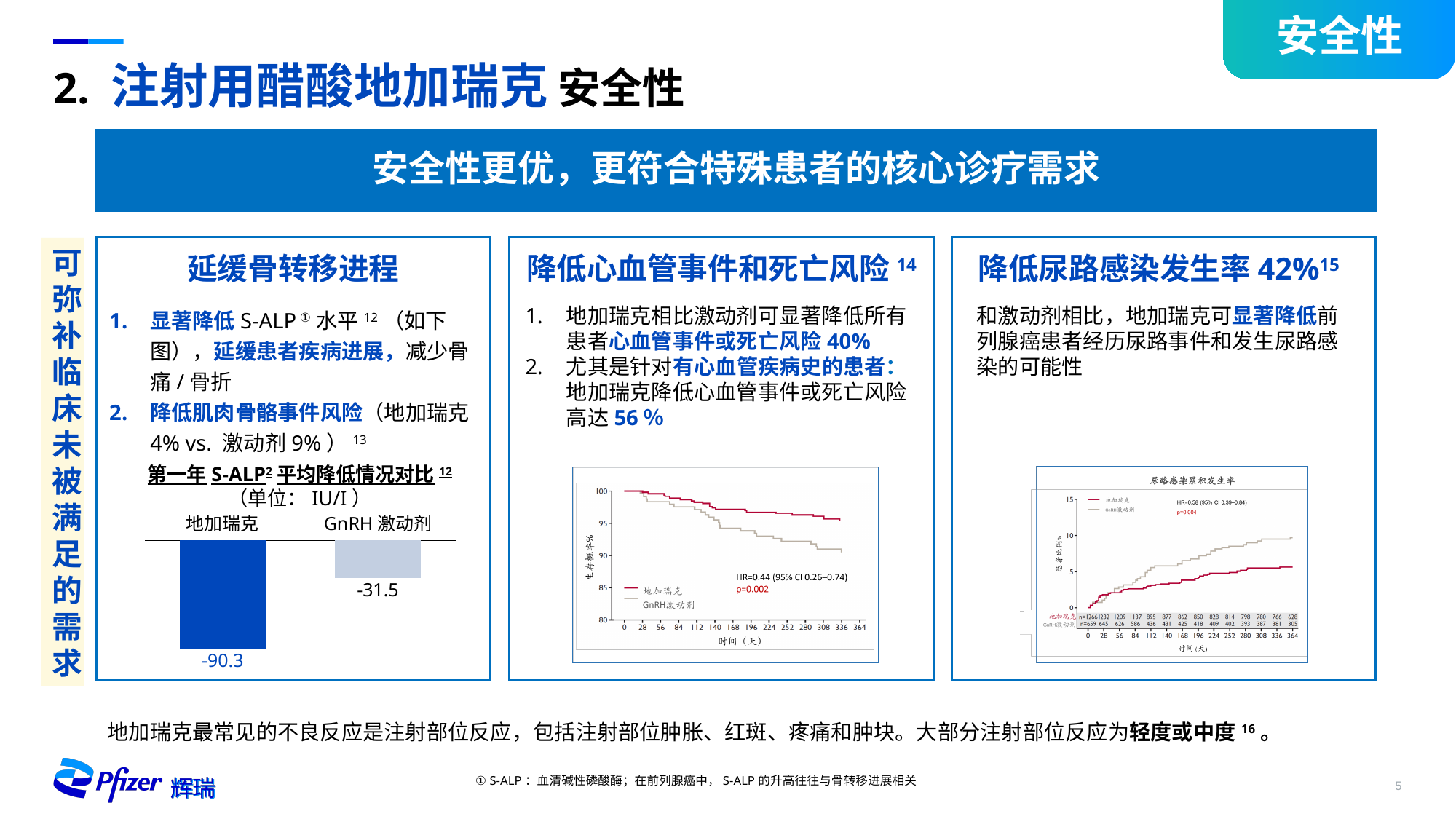
How many categories are shown in the bar chart titled 第一年 S-ALP 平均降低情况对比? 2 In the bar chart titled 第一年 S-ALP 平均降低情况对比, which category shows the larger reduction in S-ALP? 地加瑞克 In the bar chart titled 第一年 S-ALP 平均降低情况对比, what is the value for 地加瑞克? -90.3 What kind of chart is the one in the middle panel (降低心血管事件和死亡风险)? line chart How many series does the legend list in the middle panel's survival chart? 2 In the bar chart titled 第一年 S-ALP 平均降低情况对比, what is the value for GnRH 激动剂? -31.5 In the middle panel's survival chart, do the curves rise or fall along the x axis (时间)? fall In the bar chart titled 第一年 S-ALP 平均降低情况对比, what is the difference between the values for 地加瑞克 and GnRH 激动剂? 58.8 In the chart titled 尿路感染累积发生率, which series reaches the higher cumulative incidence at the end of the x axis? GnRH激动剂 What unit is stated for the bar chart titled 第一年 S-ALP 平均降低情况对比? IU/l In the chart titled 尿路感染累积发生率, do the curves rise or fall along the x axis (时间)? rise What hazard ratio is printed on the middle panel's survival chart? HR=0.44 (95% CI 0.26–0.74)